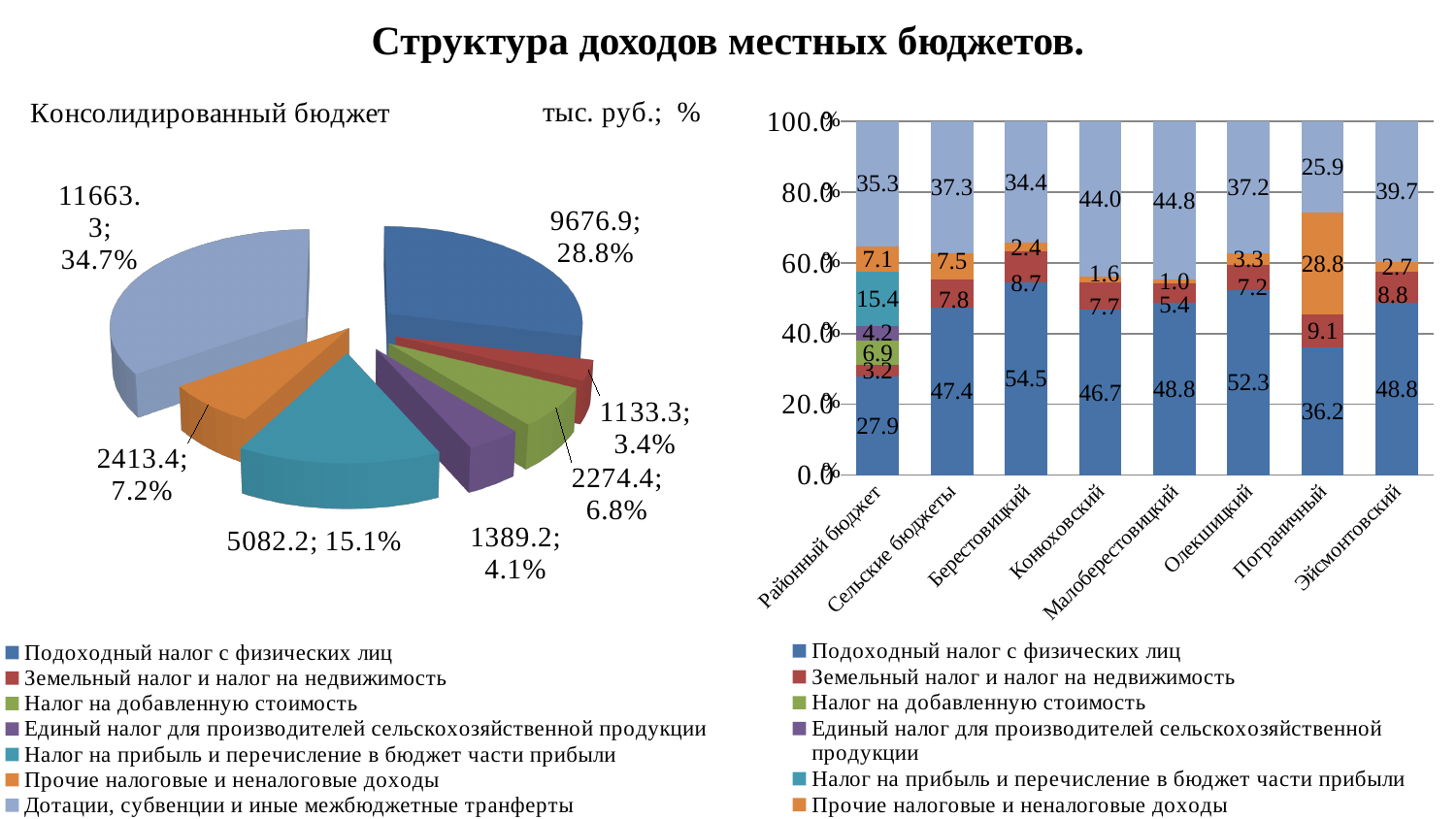
In the pie chart 'Консолидированный бюджет', what is the difference in percentage points between the Налог на прибыль slice (15.1%) and the Прочие налоговые и неналоговые доходы slice (7.2%)? 7.9 What kind of chart is the right chart? stacked bar chart In the pie chart 'Консолидированный бюджет', what share does the largest slice (Дотации, субвенции и иные межбюджетные трансферты) have? 34.7% What kind of chart is the left chart titled 'Консолидированный бюджет'? pie chart How many series does the legend of the left pie chart list? 7 In the right stacked bar chart, how many categories are shown on the x axis? 8 In the pie chart 'Консолидированный бюджет', which slice is the smallest? Земельный налог и налог на недвижимость In the right stacked bar chart, which category has the highest value for Подоходный налог с физических лиц? Берестовицкий In the right stacked bar chart, what is the value of Подоходный налог с физических лиц for Берестовицкий? 54.5 In the right stacked bar chart, which category has the lowest value for Подоходный налог с физических лиц? Районный бюджет In the right stacked bar chart, is the Прочие налоговые и неналоговые доходы value for Пограничный larger or smaller than that for Эйсмонтовский? larger In the pie chart 'Консолидированный бюджет', what is the value for Подоходный налог с физических лиц in тыс. руб.? 9676.9